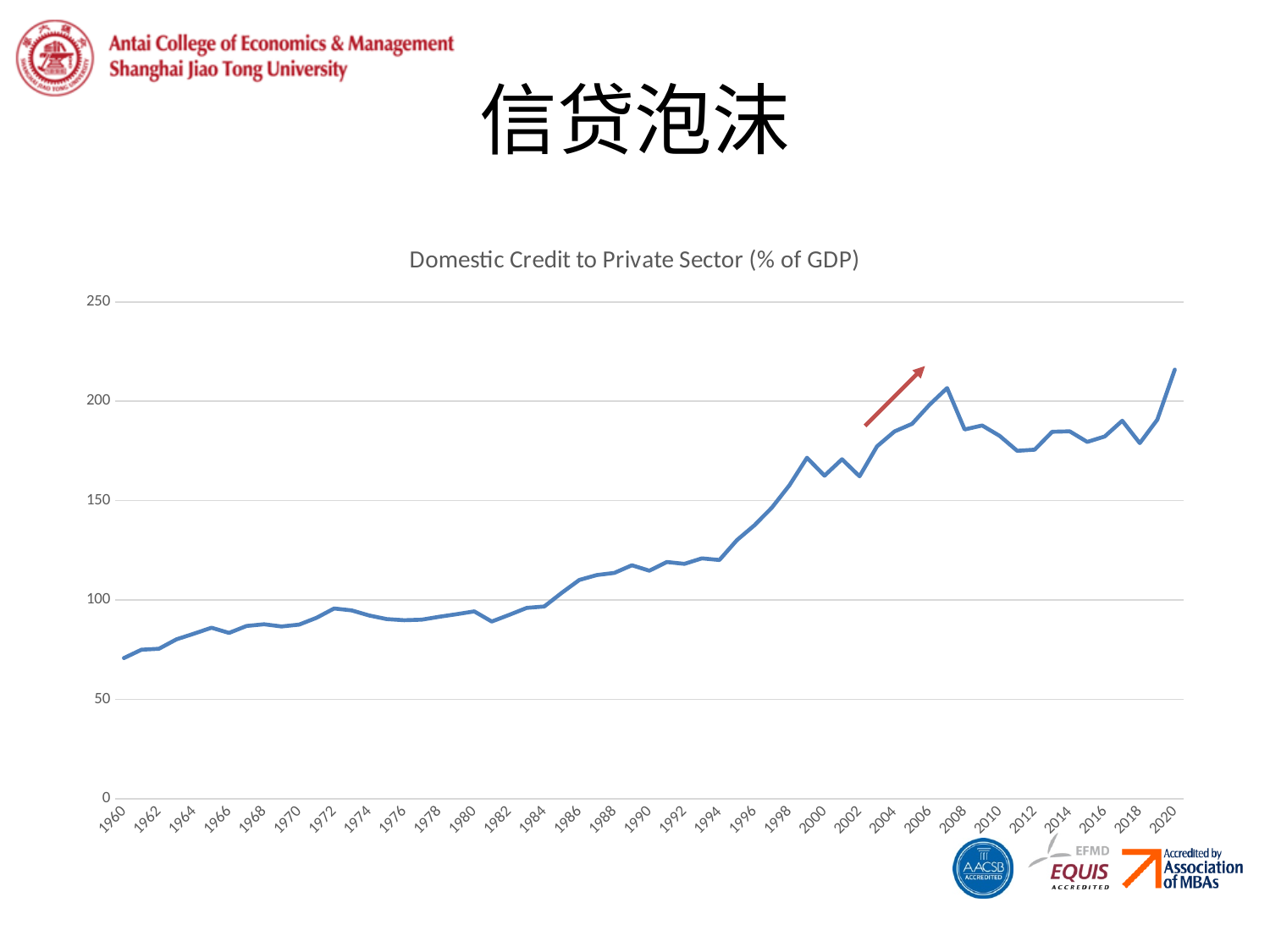
Is the value for 1960 greater or less than 100? less Which is larger, the value for 2000 or the value for 1990? 2000 Is the value for 2020 greater or less than 200? greater Is the value for 2002 greater or less than 150? greater What is the title of the chart? Domestic Credit to Private Sector (% of GDP) What kind of chart is shown on the slide? line chart What colour is the plotted line? blue Which year has the lowest value on the chart? 1960 Which year has the highest value on the chart? 2020 Overall, do the values rise or fall from 1960 to 2020? rise